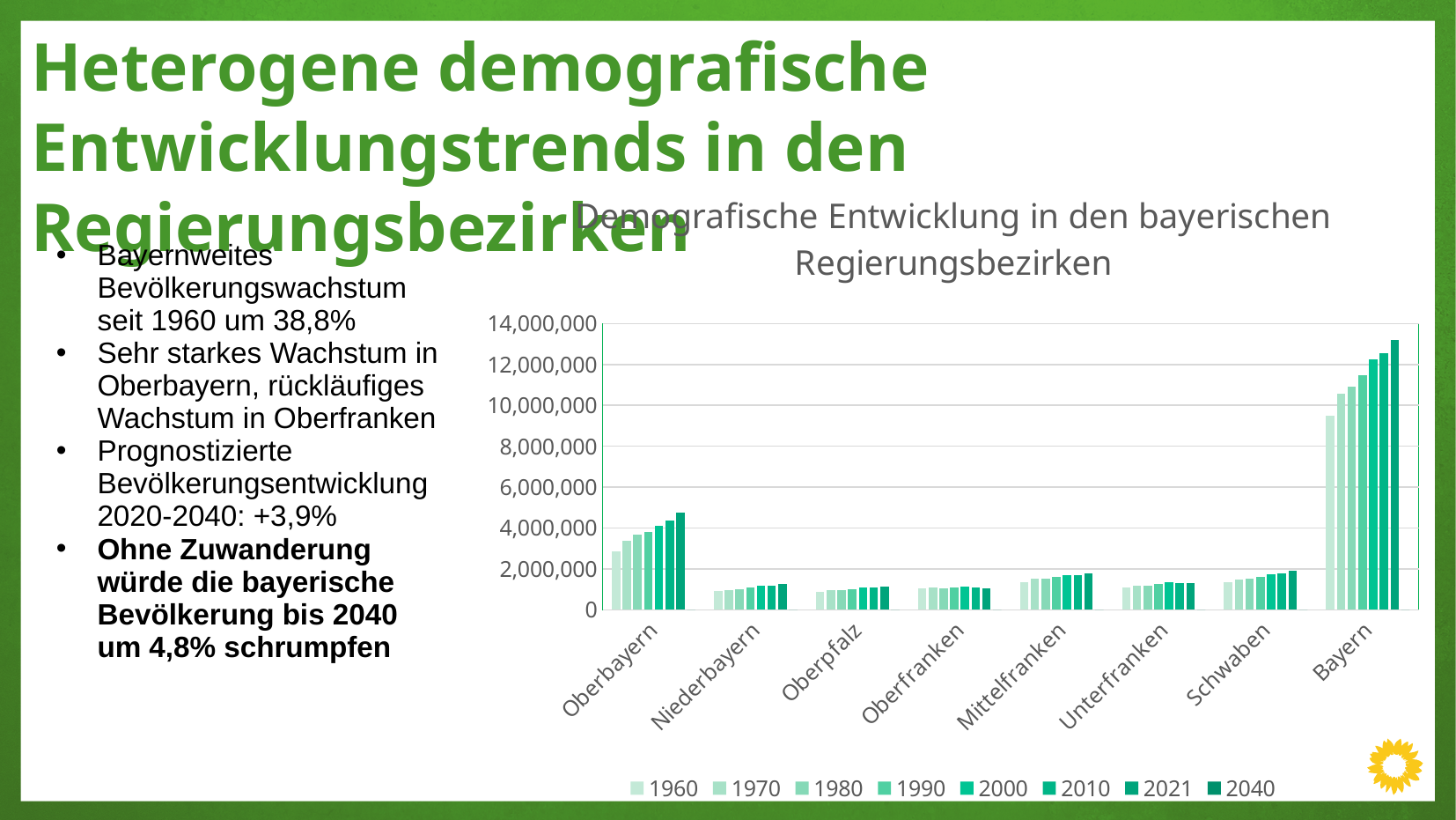
Which category has the highest bars in the chart? Bayern What is the title of the chart? Demografische Entwicklung in den bayerischen Regierungsbezirken Is the value for Oberbayern in 1960 greater or less than 2,000,000? greater What is the first series listed in the chart legend? 1960 How many categories are shown on the x axis of the chart? 8 How many series does the chart legend list? 8 What kind of chart is shown on the slide? bar chart